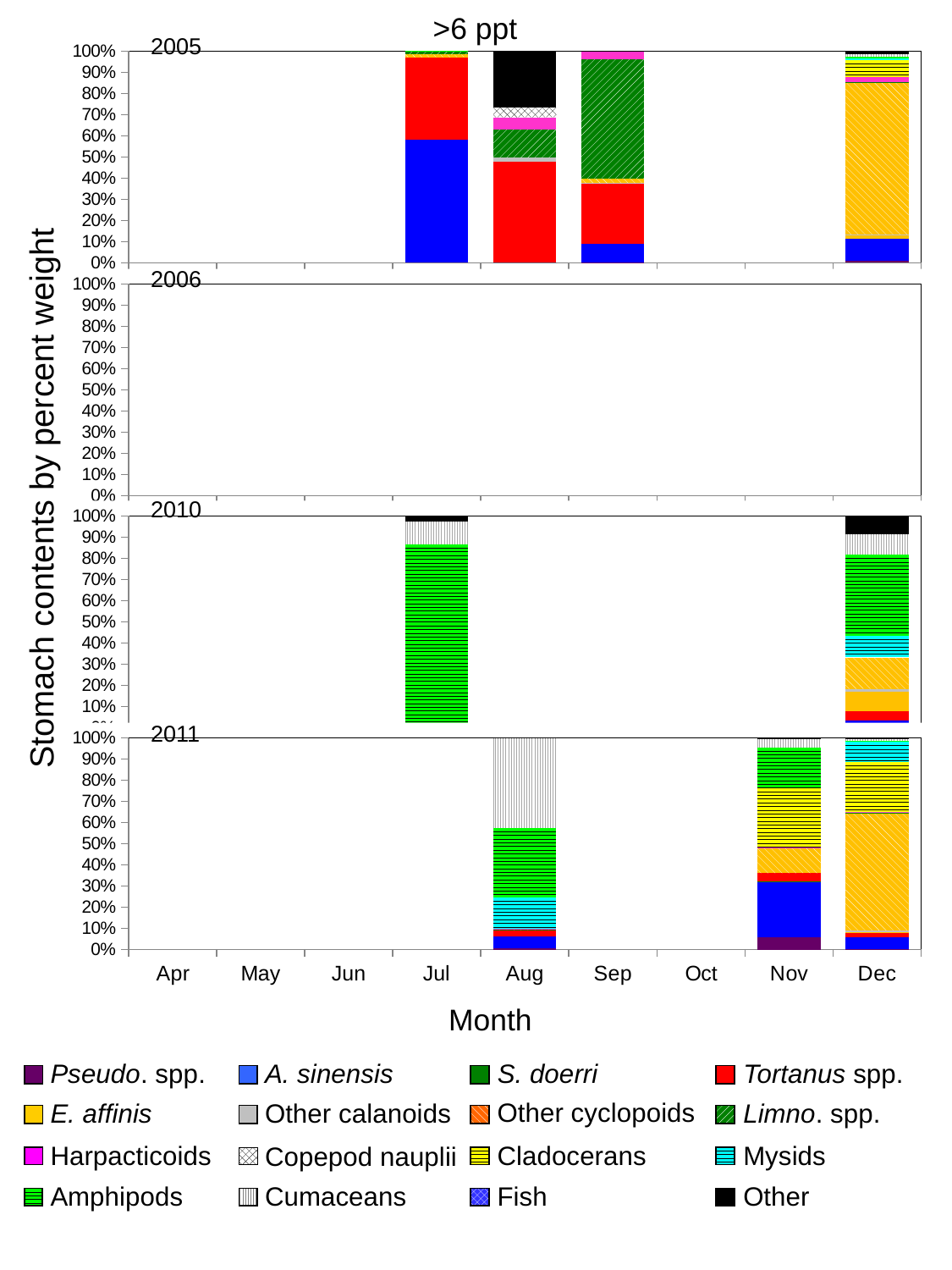
In the 2005 panel, is the A. sinensis share for Jul greater or less than 50%? greater In the 2005 panel, how many months have a bar plotted? 4 What kind of chart is used in each of the four panels on the slide? Stacked bar chart In the 2010 panel, is the Amphipods share for Jul greater or less than 70%? greater In the 2011 panel, how many months have a bar plotted? 3 In the 2005 panel for Sep, which is larger: the Limno. spp. share or the Tortanus spp. share? Limno. spp. How many entries does the legend list? 16 Which year panel contains no bars at all? 2006 In the 2005 panel for Jul, which is larger: the A. sinensis share or the Tortanus spp. share? A. sinensis In the 2005 panel, is the E. affinis share for Dec greater or less than 50%? less How many months are shown along the x axis? 9 What is the title shown above the charts? >6 ppt